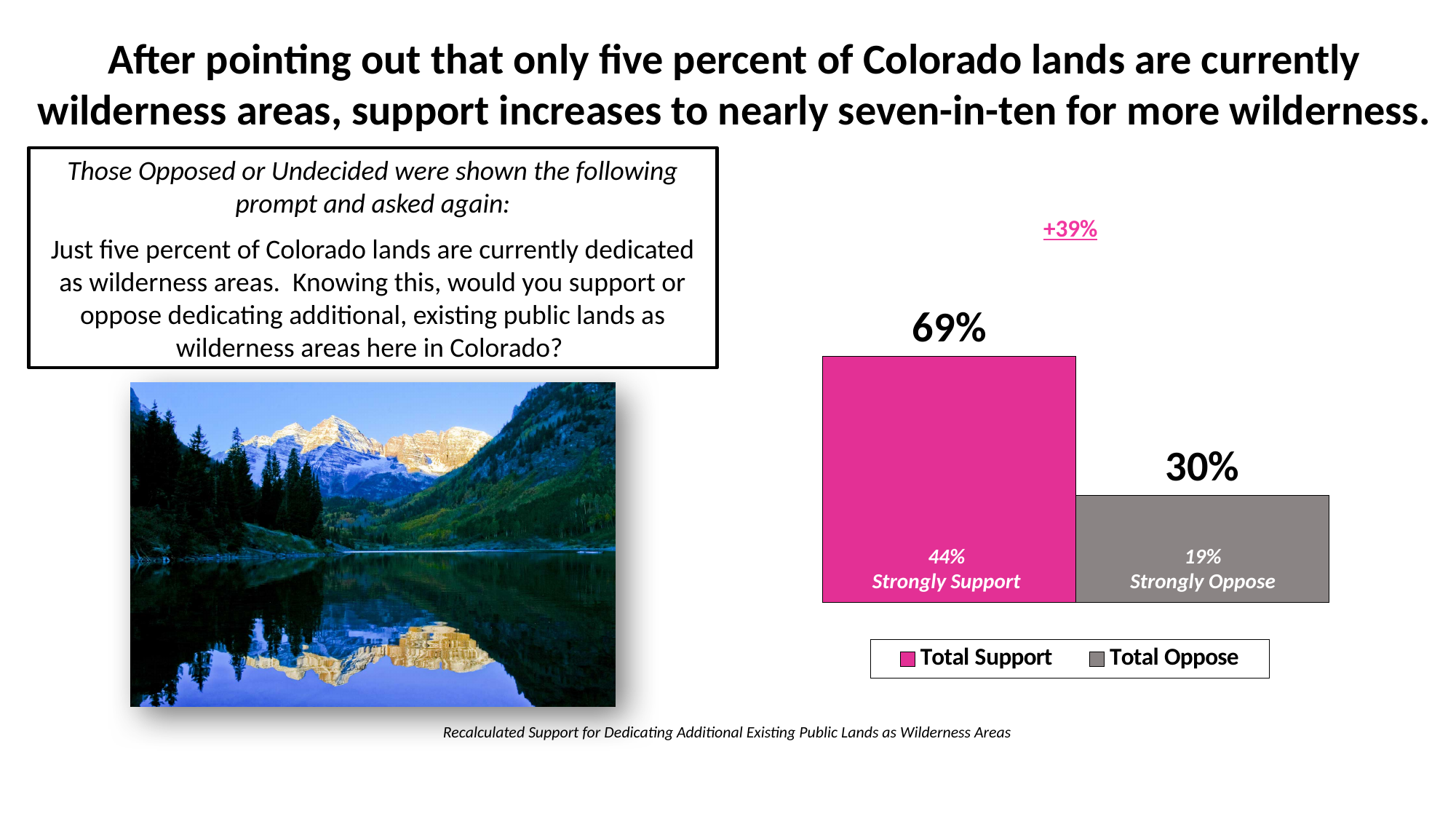
How many series does the legend list? 2 What percentage Strongly Oppose? 19% What is the difference between Strongly Support and Strongly Oppose? 25% What is the value for Total Oppose? 30% Which series has the lower value, Total Support or Total Oppose? Total Oppose What is the difference between Total Support and Total Oppose? 39% Which series has the higher value, Total Support or Total Oppose? Total Support What is the value for Total Support? 69% Is Strongly Support larger or smaller than Strongly Oppose? larger What kind of chart is shown? bar chart What percentage Strongly Support? 44% What change is annotated above the bars? +39%